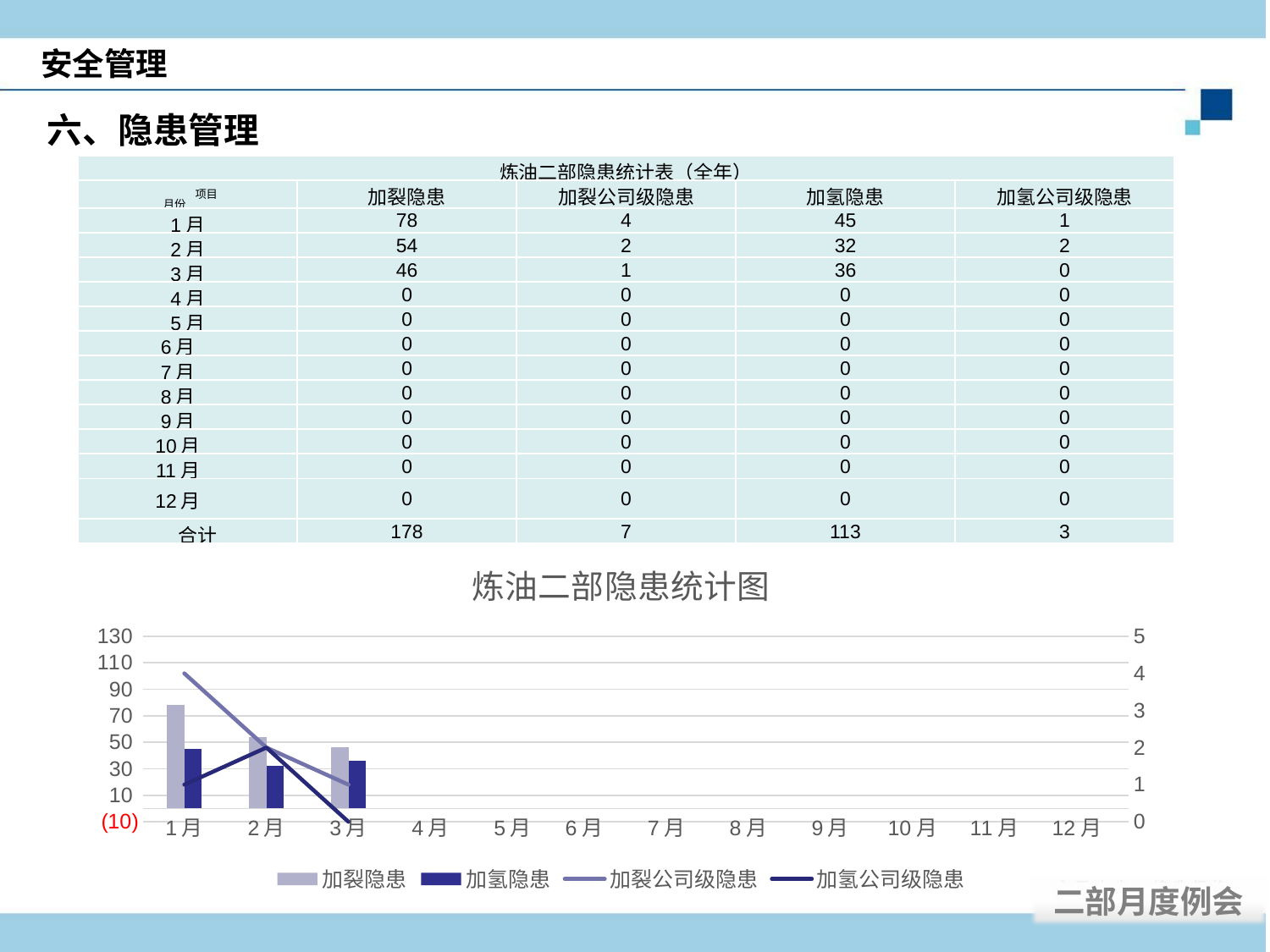
What is the difference between 加裂隐患 and 加氢隐患 for 1月 according to the slide? 33 What kind of chart is 炼油二部隐患统计图? A combined bar and line chart What is the title of the chart on the slide? 炼油二部隐患统计图 In 炼油二部隐患统计图, do the 加裂隐患 bars rise or fall from 1月 to 3月? fall In 炼油二部隐患统计图, is the 加氢隐患 bar for 2月 greater or less than 50? less In 炼油二部隐患统计图, which month has the highest 加裂隐患 bar? 1月 In 炼油二部隐患统计图, which is larger for 1月: 加裂隐患 or 加氢隐患? 加裂隐患 What is the 加裂公司级隐患 value for 1月 shown on the slide? 4 What is the 加氢公司级隐患 value for 3月 shown on the slide? 0 In 炼油二部隐患统计图, is the 加裂隐患 bar for 1月 greater or less than 70? greater How many months are shown on the x axis of 炼油二部隐患统计图? 12 How many series does the legend of 炼油二部隐患统计图 list? 4